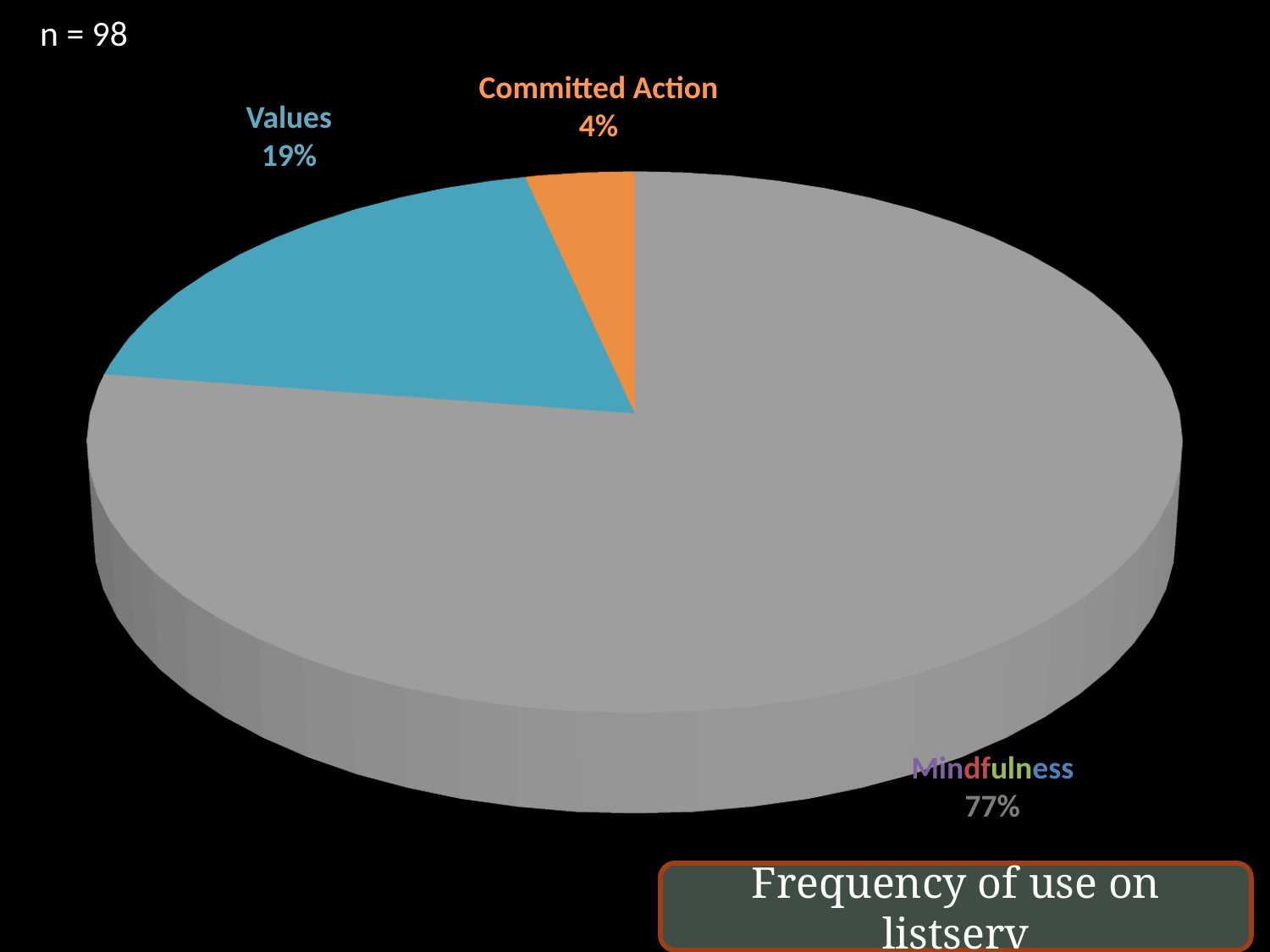
What colour is the Values slice? blue What share of the pie does Values take? 19% How many slices does the pie chart have? 3 What is the difference in percentage points between Values and Committed Action? 15 What share of the pie does Committed Action take? 4% Which slice of the pie is the smallest? Committed Action What share of the pie does Mindfulness take? 77% What is the sample size (n) shown on the slide? 98 Which is larger, the Values slice or the Committed Action slice? Values Which slice of the pie is the largest? Mindfulness What kind of chart is shown on the slide? pie chart What is the difference in percentage points between Mindfulness and Values? 58